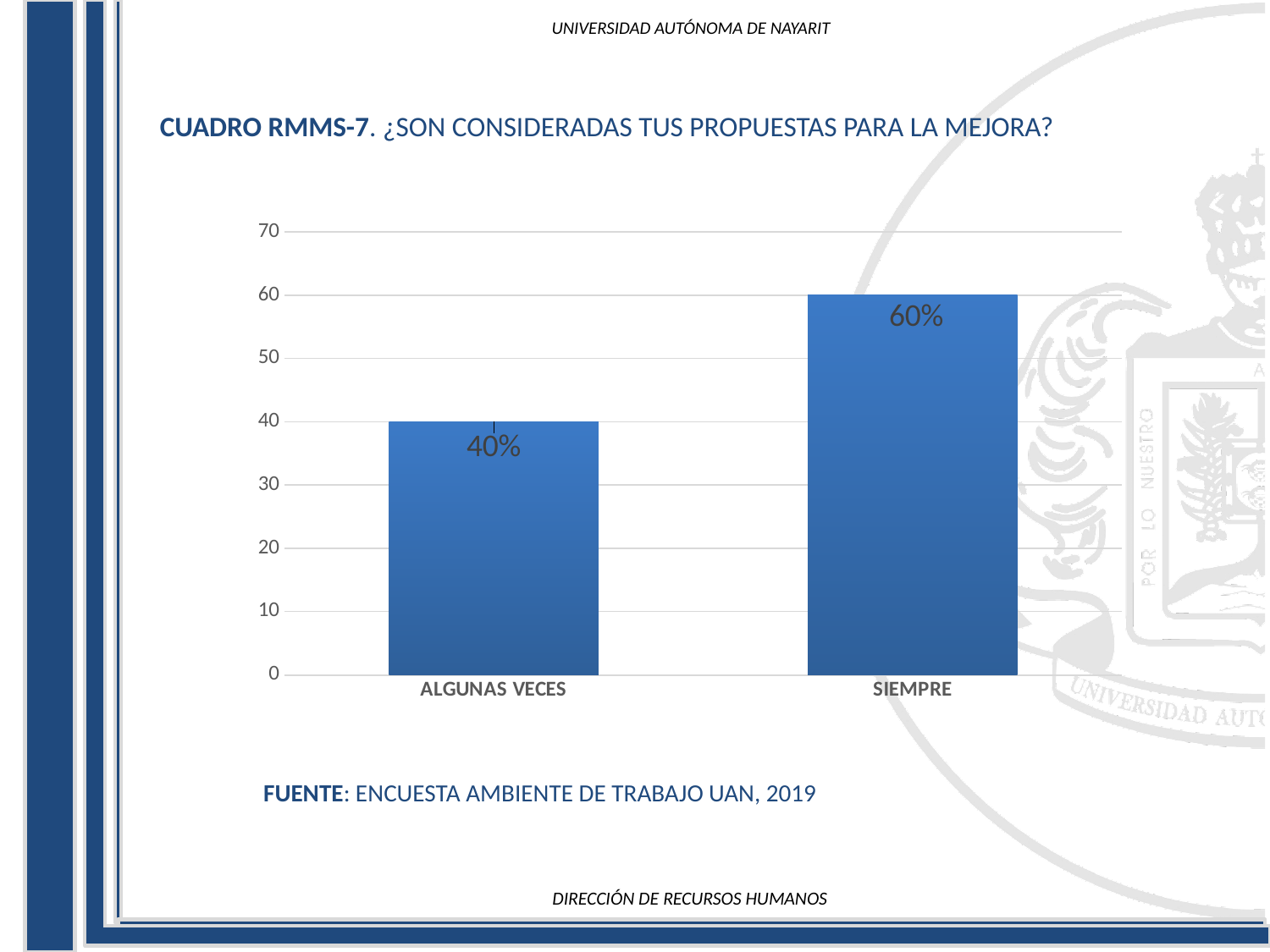
What is the value for ALGUNAS VECES? 40% Is the value for ALGUNAS VECES greater or less than 50? less Do the values rise or fall from left to right along the x axis? rise Which is larger, the value for ALGUNAS VECES or the value for SIEMPRE? SIEMPRE What kind of chart is shown on the slide? bar chart What is the value for SIEMPRE? 60% What is the difference between the values for SIEMPRE and ALGUNAS VECES? 20% What is the source cited below the chart? ENCUESTA AMBIENTE DE TRABAJO UAN, 2019 Is the value for SIEMPRE greater or less than 50? greater Which category has the highest value? SIEMPRE Which category has the lowest value? ALGUNAS VECES How many categories are shown on the x axis? 2